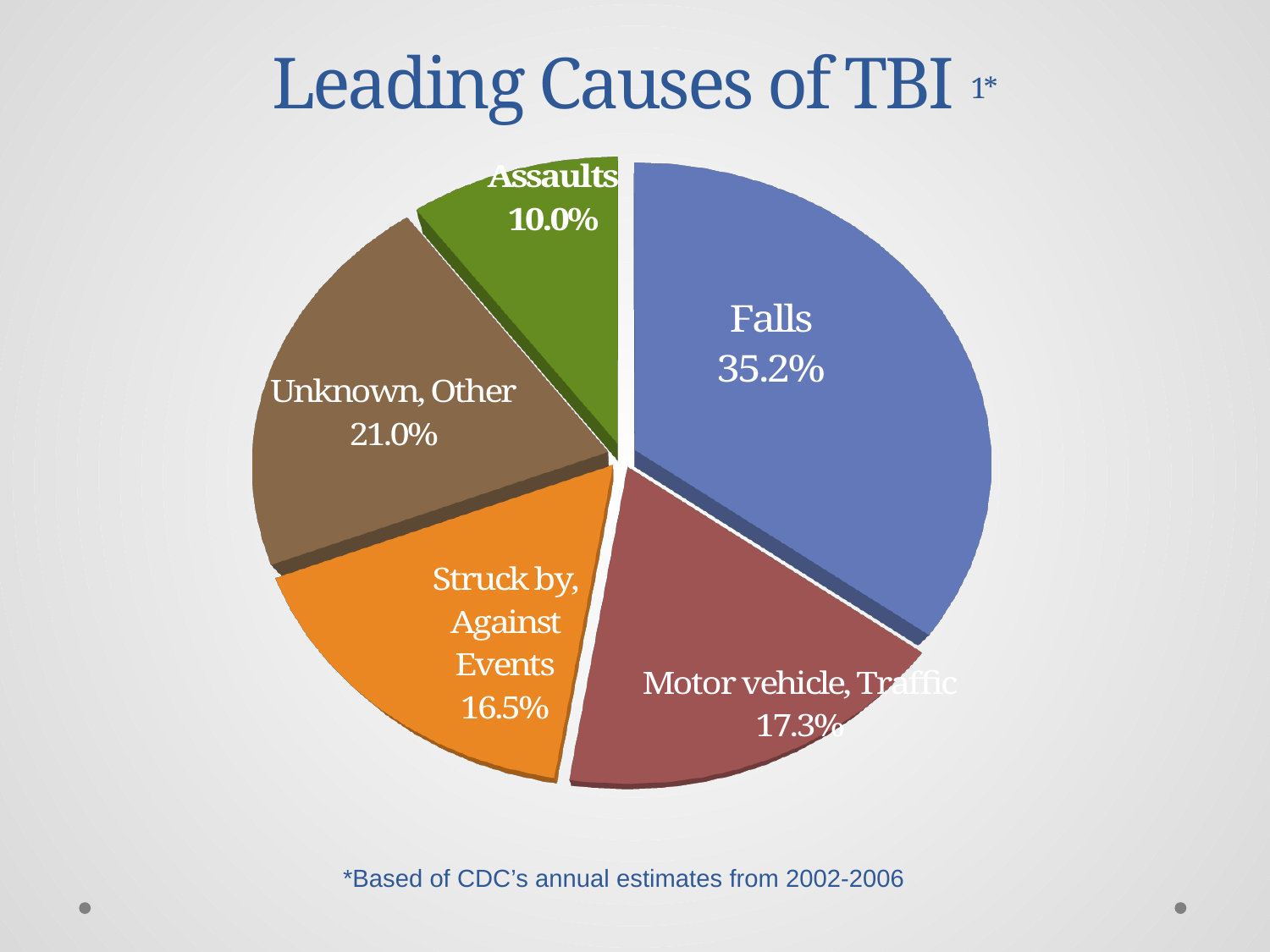
How many slices does the pie chart have? 5 Which cause has the largest share of the pie? Falls Which is larger, Motor vehicle, Traffic or Struck by, Against Events? Motor vehicle, Traffic What is the title of the chart? Leading Causes of TBI What percentage is shown for Motor vehicle, Traffic? 17.3% What percentage is shown for Assaults? 10.0% Which cause has the smallest share of the pie? Assaults What percentage is shown for Unknown, Other? 21.0% What is the difference in percentage points between Falls and Unknown, Other? 14.2 What percentage of TBI is attributed to Falls? 35.2% What percentage is shown for Struck by, Against Events? 16.5% What kind of chart is shown on the slide? Pie chart